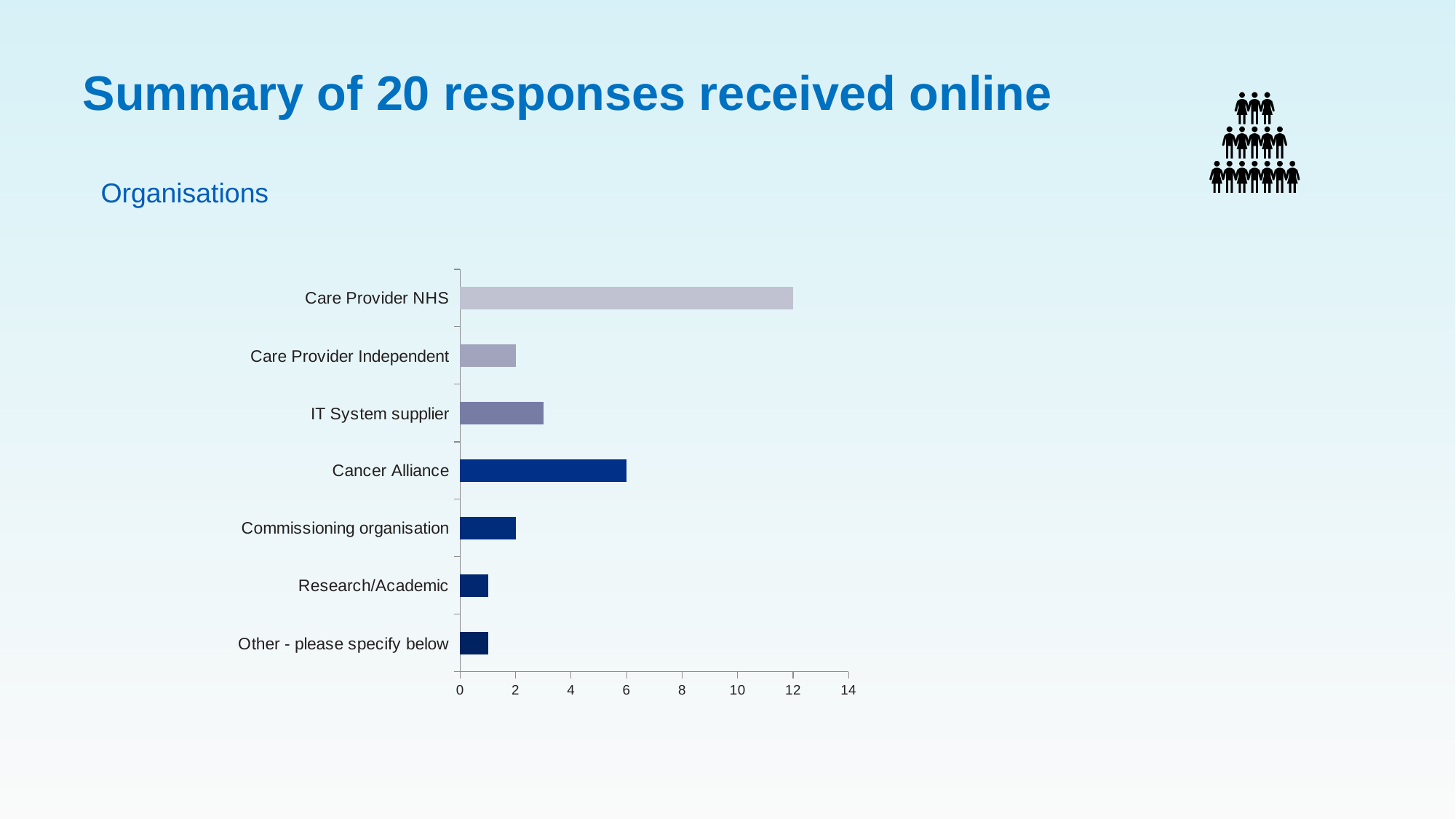
Which organisation category has the highest number of responses? Care Provider NHS Is the value for IT System supplier greater or less than 4? less How many responses are shown for Care Provider NHS? 12 What is the highest value shown on the horizontal axis of the chart? 14 How many responses are shown for Care Provider Independent? 2 How many organisation categories are plotted in the chart? 7 How many responses are shown for Cancer Alliance? 6 Which has more responses, Cancer Alliance or Care Provider Independent? Cancer Alliance How many responses are shown for Commissioning organisation? 2 Is the value for Research/Academic greater or less than 2? less What type of chart is shown on the slide? bar chart What is the difference between the responses for Care Provider NHS and Cancer Alliance? 6